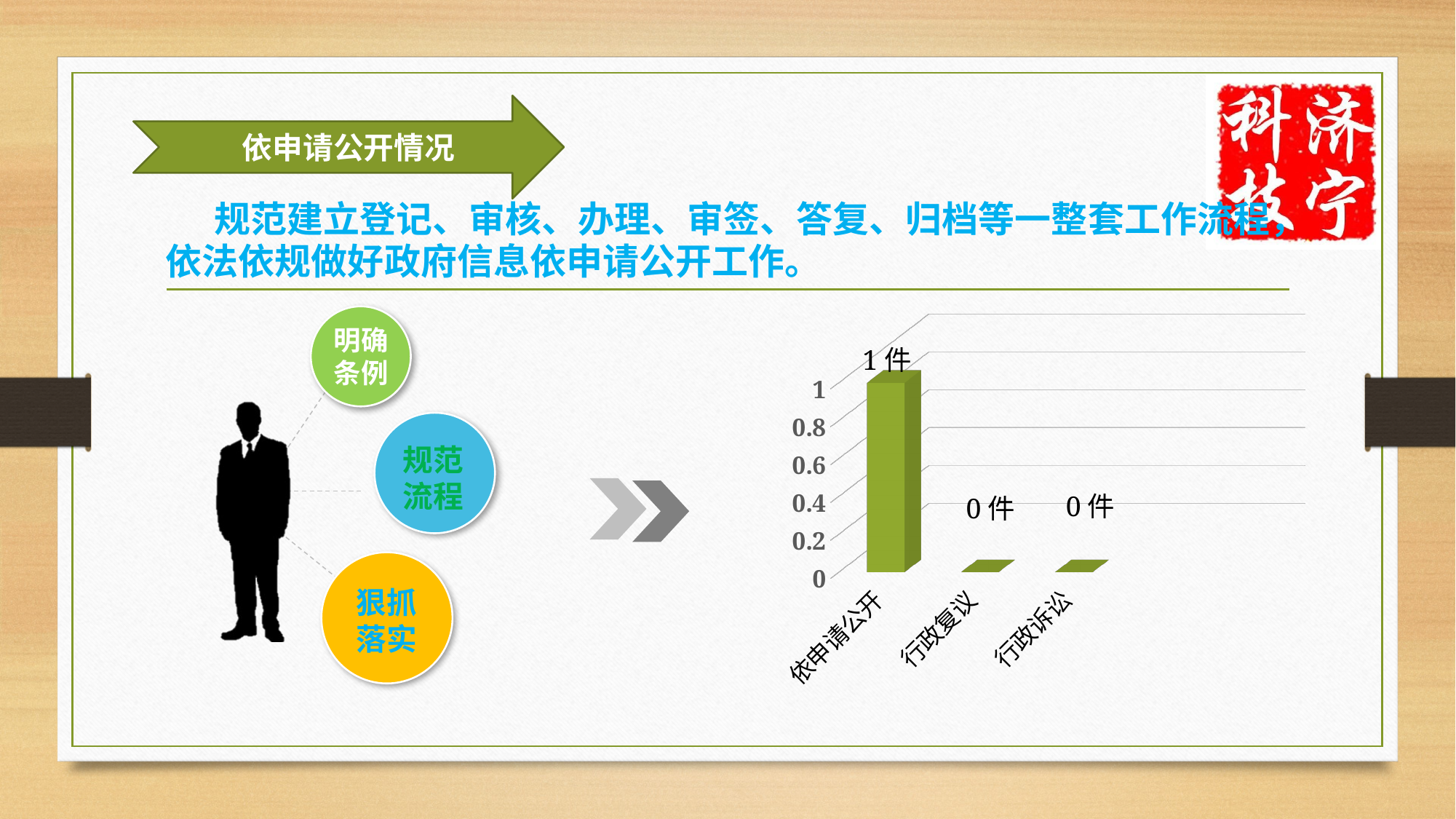
What is the highest tick value shown on the vertical axis of the bar chart? 1 What is the value for 行政诉讼 in the bar chart? 0 件 Which is larger, the value for 依申请公开 or the value for 行政诉讼? 依申请公开 What is the difference between the values for 依申请公开 and 行政复议? 1 件 Which category has the highest value in the bar chart? 依申请公开 What is the value for 依申请公开 in the bar chart? 1 件 What is the value for 行政复议 in the bar chart? 0 件 What is the total of the three values shown in the bar chart? 1 件 What kind of chart is shown on the right side of the slide? bar chart How many categories are shown on the x axis of the bar chart? 3 Do the values rise or fall from 依申请公开 to 行政诉讼 along the x axis? fall Is the value for 依申请公开 greater or less than 0.6? greater